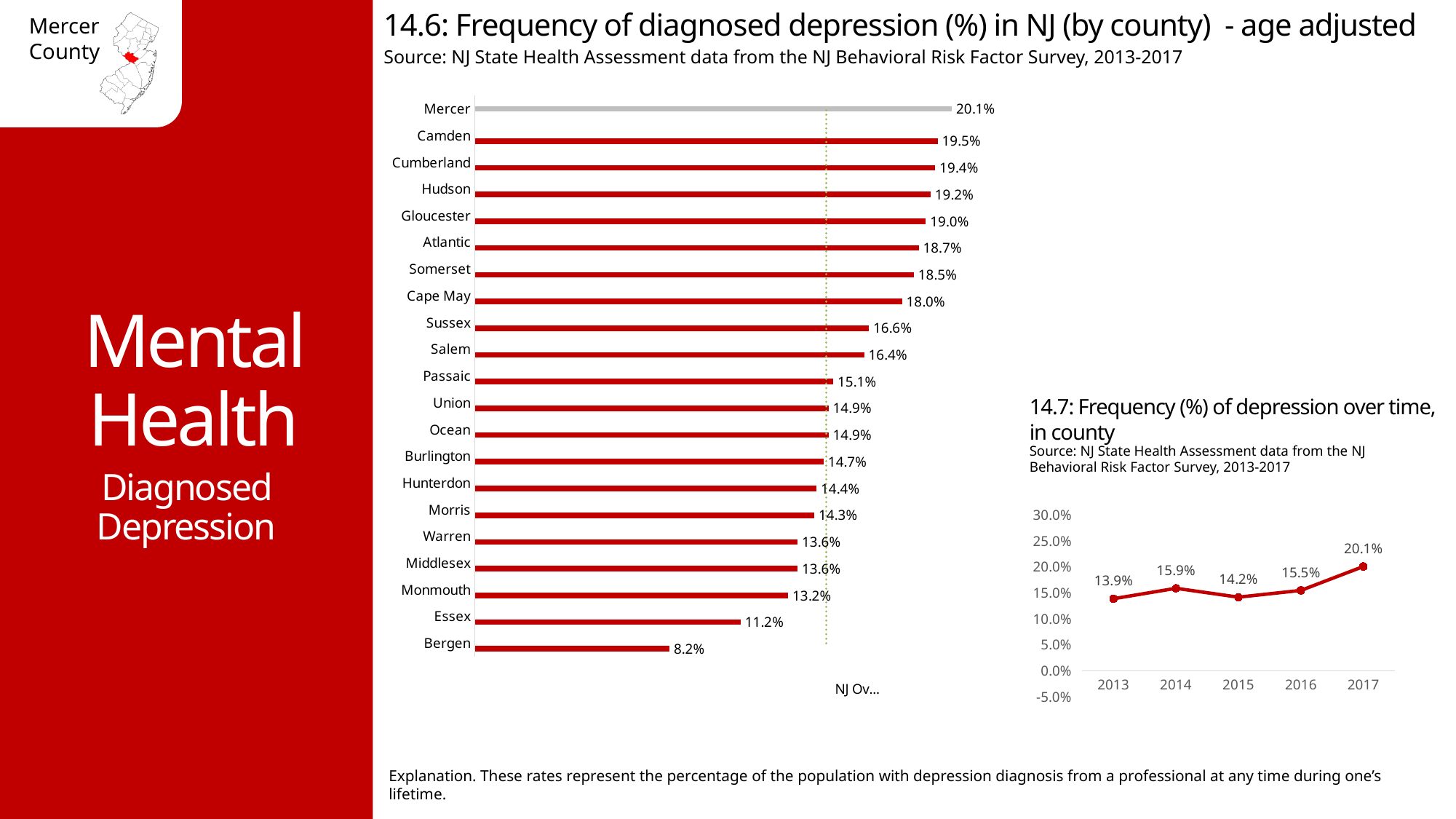
In the chart '14.6: Frequency of diagnosed depression (%) in NJ (by county)', which county has the highest value? Mercer In the chart '14.6: Frequency of diagnosed depression (%) in NJ (by county)', what is the value for Mercer? 20.1% In the chart '14.7: Frequency (%) of depression over time, in county', what is the value for 2015? 14.2% What kind of chart is '14.6: Frequency of diagnosed depression (%) in NJ (by county)'? Bar chart In the chart '14.6: Frequency of diagnosed depression (%) in NJ (by county)', which county has the lowest value? Bergen In the chart '14.6: Frequency of diagnosed depression (%) in NJ (by county)', what is the value for Essex? 11.2% In the chart '14.7: Frequency (%) of depression over time, in county', what is the difference between 2017 and 2013? 6.2% In the chart '14.7: Frequency (%) of depression over time, in county', which year has the highest value? 2017 How many counties are shown in the chart '14.6: Frequency of diagnosed depression (%) in NJ (by county)'? 21 In the chart '14.6: Frequency of diagnosed depression (%) in NJ (by county)', which is larger, Camden or Hudson? Camden What kind of chart is '14.7: Frequency (%) of depression over time, in county'? Line chart In the chart '14.6: Frequency of diagnosed depression (%) in NJ (by county)', what is the difference between Mercer and Bergen? 11.9%